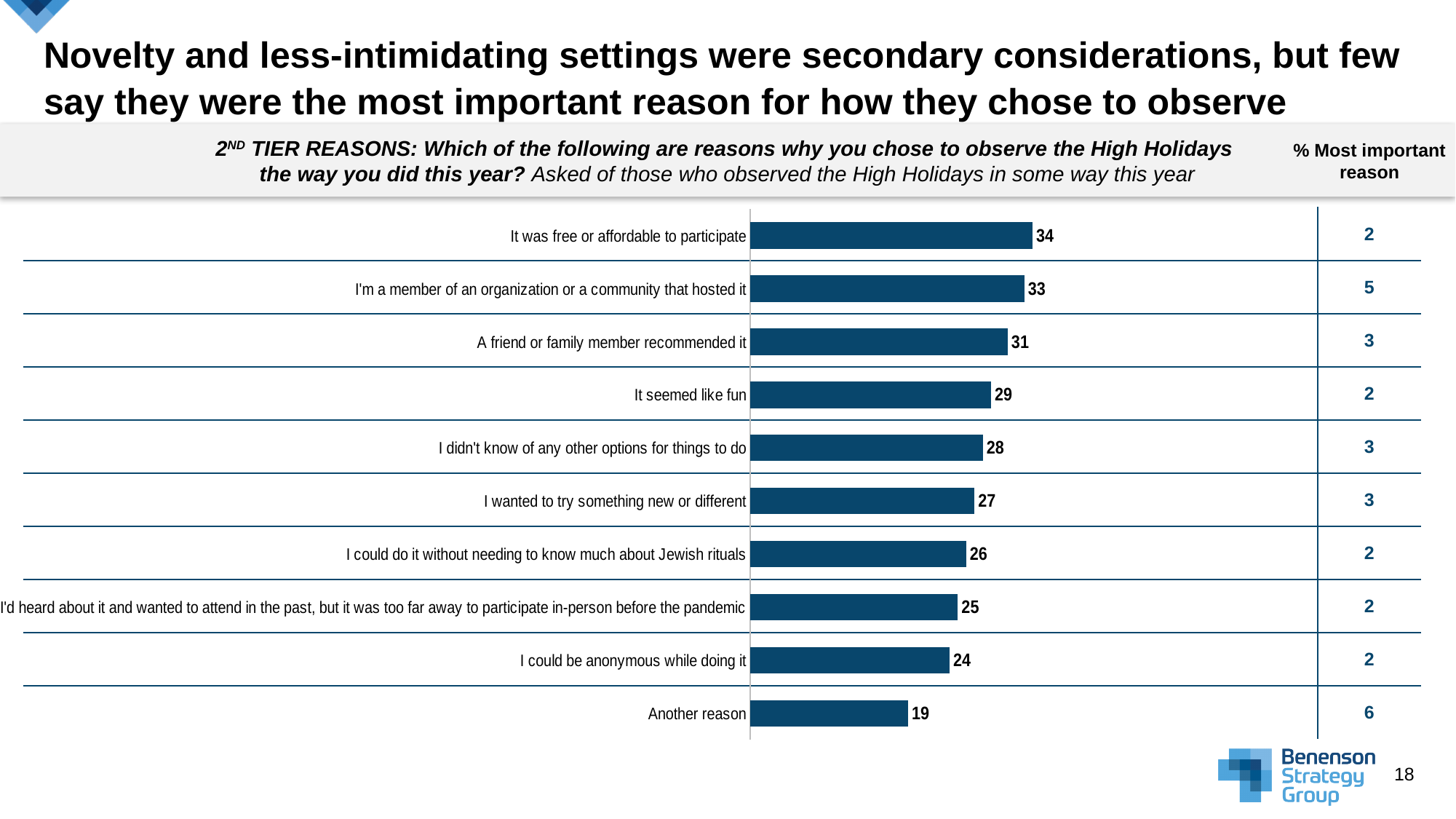
How many reasons (bars) are shown in the chart? 10 Which reason has the lowest value in the bar chart? Another reason What value is shown for "It was free or affordable to participate"? 34 What is the difference between the values for "It was free or affordable to participate" and "Another reason"? 15 Which is larger: the value for "It seemed like fun" or the value for "I could be anonymous while doing it"? It seemed like fun What is the difference between the values for "I'm a member of an organization or a community that hosted it" and "A friend or family member recommended it"? 2 What value is shown for "I could be anonymous while doing it"? 24 Which reason has the highest value in the bar chart? It was free or affordable to participate In the "% Most important reason" column, which reason has the highest value? Another reason What value is shown for "I wanted to try something new or different"? 27 What kind of chart is shown on the slide? Bar chart What is the "% Most important reason" value for "I'm a member of an organization or a community that hosted it"? 5